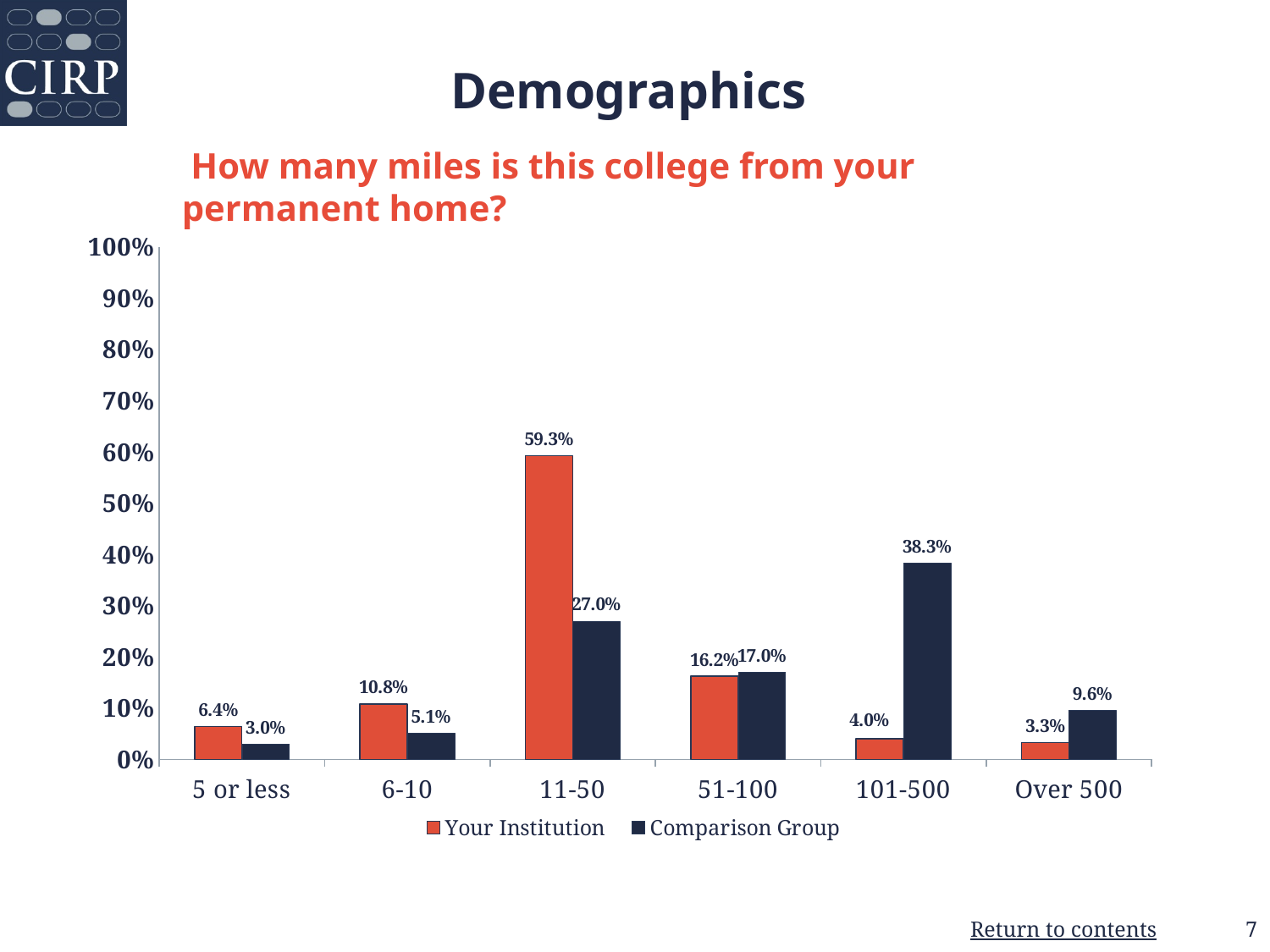
What is the difference between Your Institution and Comparison Group in the 11-50 category? 32.3% How many series does the legend list? 2 Which category has the lowest value for Comparison Group? 5 or less Which is larger in the 101-500 category, Your Institution or Comparison Group? Comparison Group How many categories are shown on the x axis? 6 What is the value for Your Institution in the Over 500 category? 3.3% What kind of chart is shown on the slide? bar chart What is the value for Your Institution in the 11-50 category? 59.3% Which category has the highest value for Your Institution? 11-50 Which category has the highest value for Comparison Group? 101-500 Is the value for Your Institution in the 11-50 category greater or less than 50%? greater What is the value for Comparison Group in the 101-500 category? 38.3%